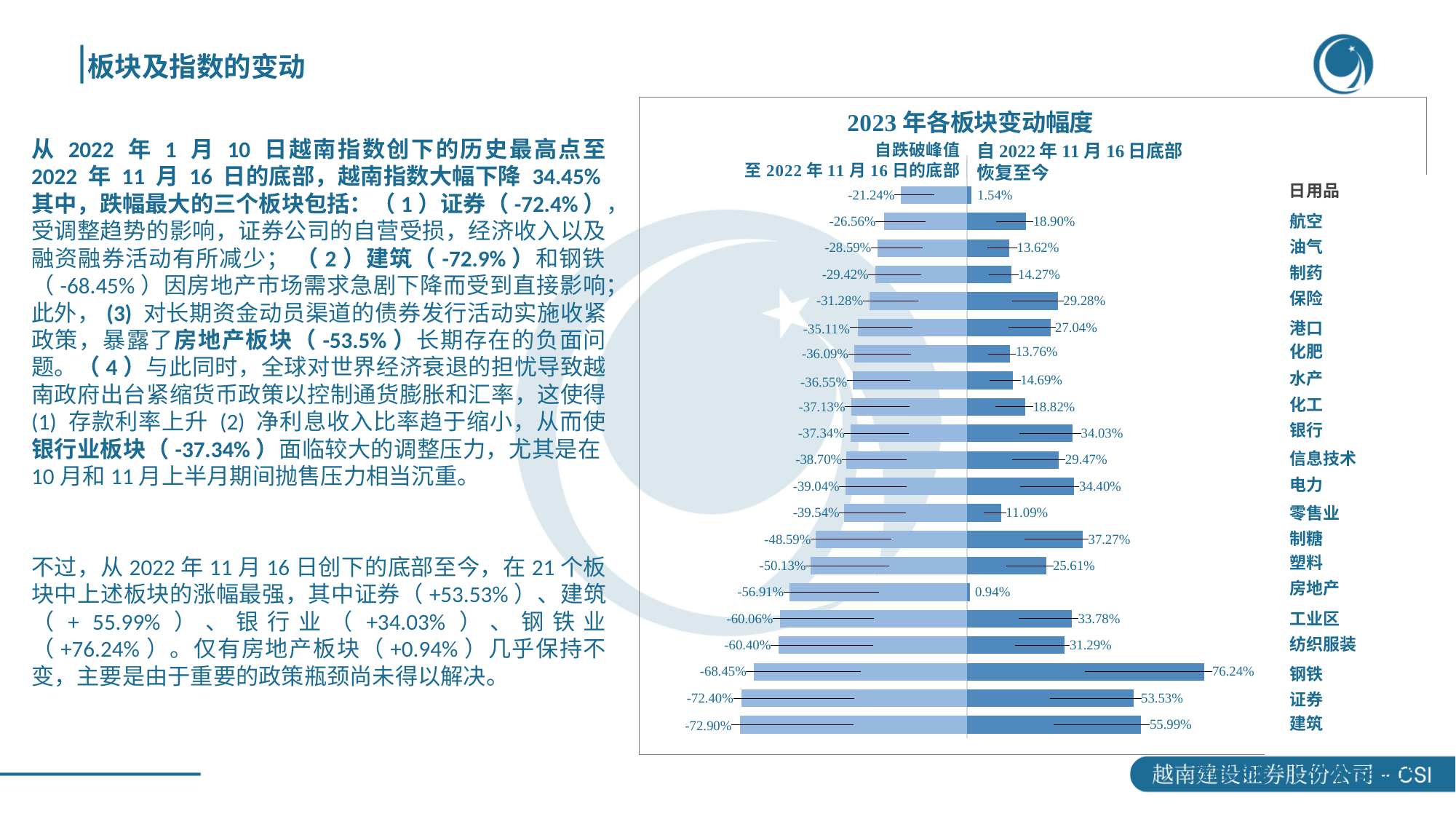
What is the value for 日用品 in the series 自跌破峰值至 2022 年 11 月 16 日的底部? -21.24% In the series 自 2022 年 11 月 16 日底部恢复至今, which is larger: 制糖 or 塑料? 制糖 What is the value for 银行 in the series 自跌破峰值至 2022 年 11 月 16 日的底部? -37.34% Which sector has the highest value in the series 自 2022 年 11 月 16 日底部恢复至今? 钢铁 What is the value for 钢铁 in the series 自 2022 年 11 月 16 日底部恢复至今? 76.24% What is the difference between the recovery values (自 2022 年 11 月 16 日底部恢复至今) of 建筑 and 证券? 2.46% What type of chart is shown on the slide? bar chart How many sectors (categories) are plotted in the chart? 21 Which sector has the lowest value in the series 自跌破峰值至 2022 年 11 月 16 日的底部? 建筑 What is the title of the chart? 2023 年各板块变动幅度 How many data series does the chart show? 2 What is the value for 房地产 in the series 自 2022 年 11 月 16 日底部恢复至今? 0.94%